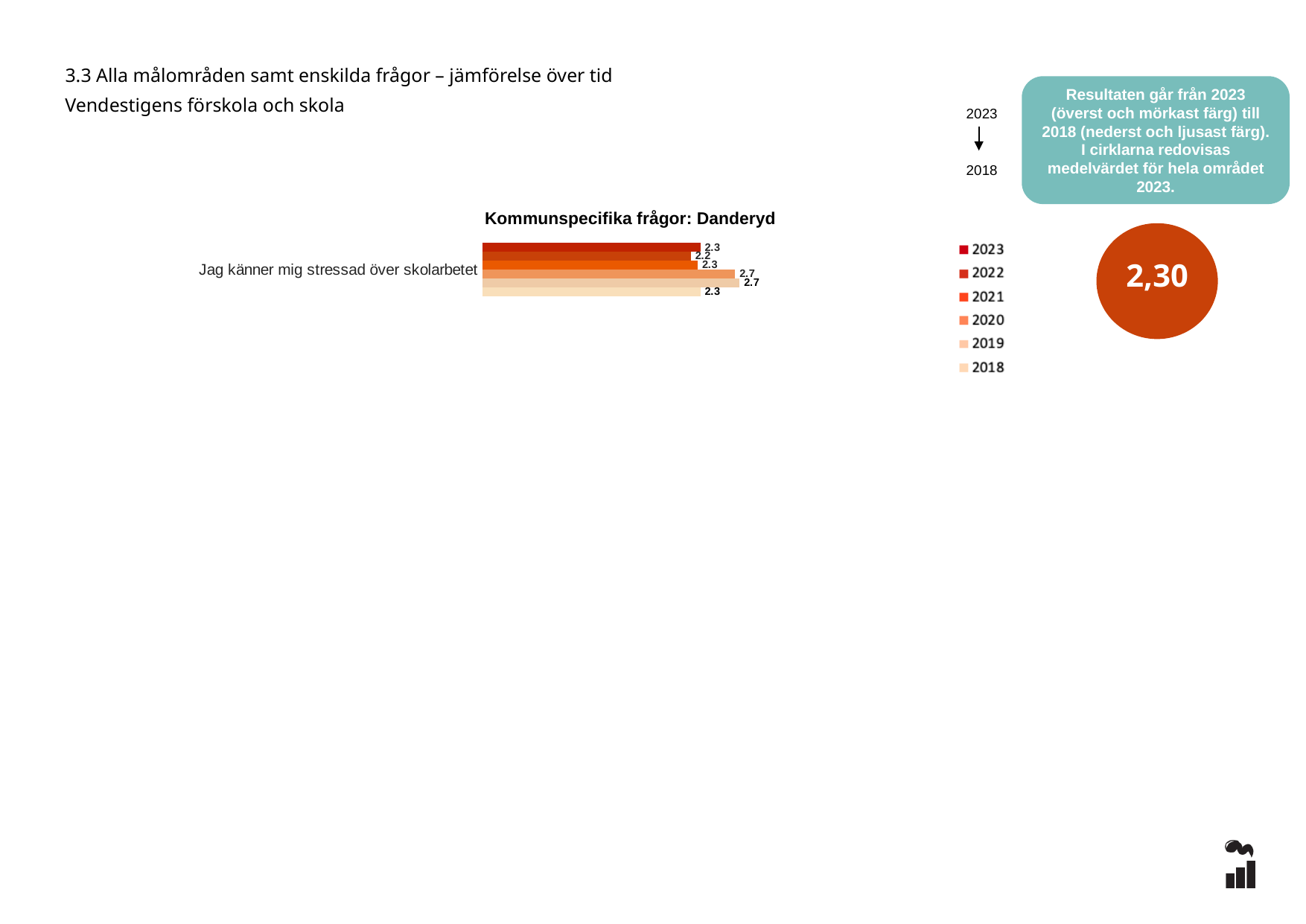
What is the 2022 value for "Jag känner mig stressad över skolarbetet"? 2.2 What is the title of the chart on the slide? Kommunspecifika frågor: Danderyd What type of chart is shown under the title "Kommunspecifika frågor: Danderyd"? bar chart What is the 2020 value for "Jag känner mig stressad över skolarbetet"? 2.7 How many series does the legend of the "Kommunspecifika frågor: Danderyd" chart list? 6 What is the 2023 value for "Jag känner mig stressad över skolarbetet"? 2.3 Which year has the lowest value for "Jag känner mig stressad över skolarbetet"? 2022 What is the difference between the 2020 value and the 2022 value for "Jag känner mig stressad över skolarbetet"? 0.5 What is the 2018 value for "Jag känner mig stressad över skolarbetet"? 2.3 How many categories are plotted in the "Kommunspecifika frågor: Danderyd" chart? 1 Which is larger for "Jag känner mig stressad över skolarbetet": the 2019 value or the 2023 value? 2019 What value is shown in the orange circle on the right of the slide? 2,30